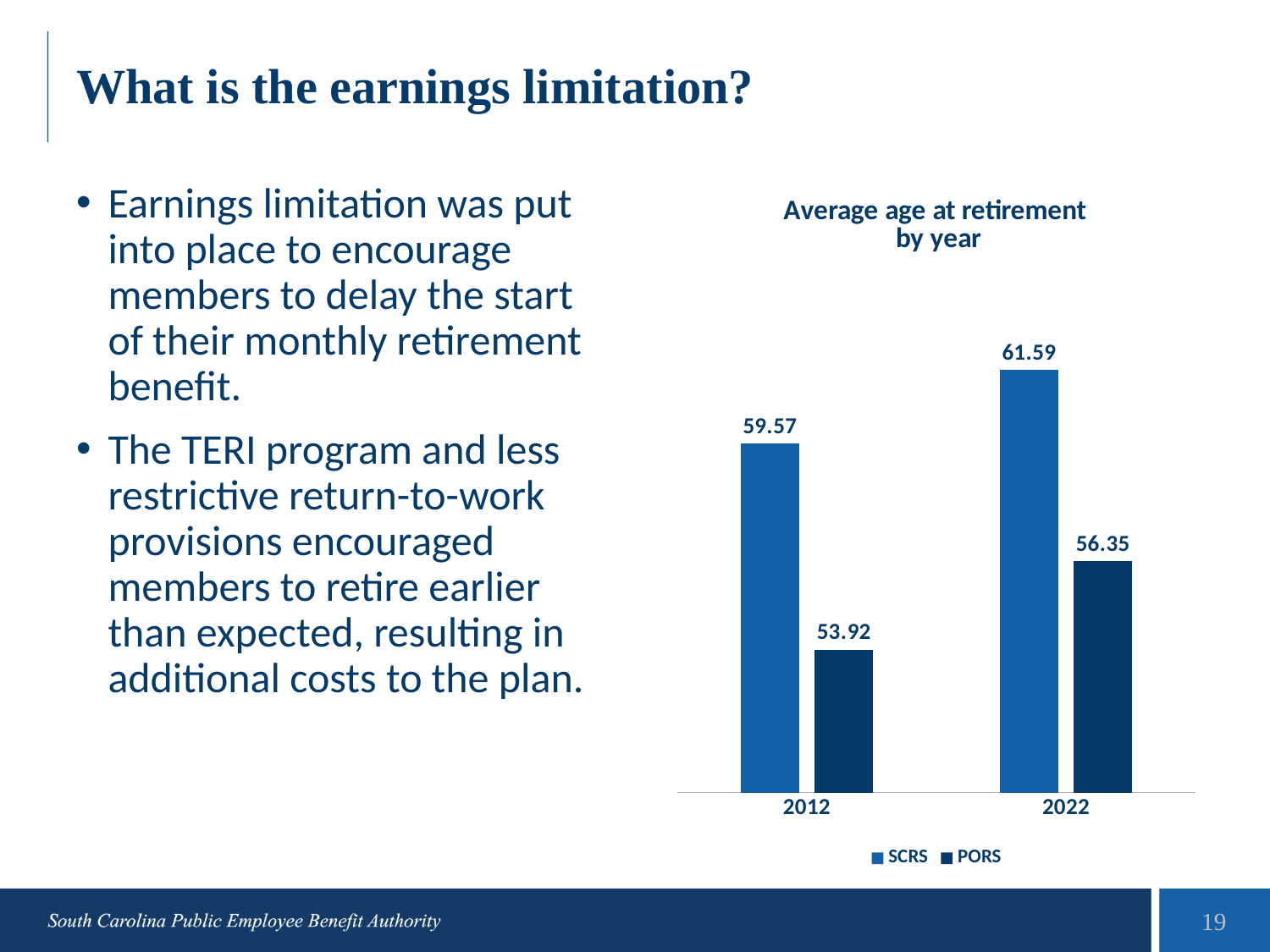
Which bar shows the lowest average age at retirement? PORS in 2012 What is the average age at retirement for PORS in 2022? 56.35 What is the average age at retirement for SCRS in 2012? 59.57 Does the SCRS average age at retirement rise or fall from 2012 to 2022? Rise How many series does the legend list? 2 Which is larger, the SCRS value in 2012 or the PORS value in 2022? SCRS in 2012 What kind of chart is shown on the slide? Bar chart By how much did the PORS average age at retirement change from 2012 to 2022? 2.43 What is the difference between the SCRS and PORS average retirement ages in 2022? 5.24 What is the average age at retirement for PORS in 2012? 53.92 What is the average age at retirement for SCRS in 2022? 61.59 Which series has the highest value shown on the chart? SCRS